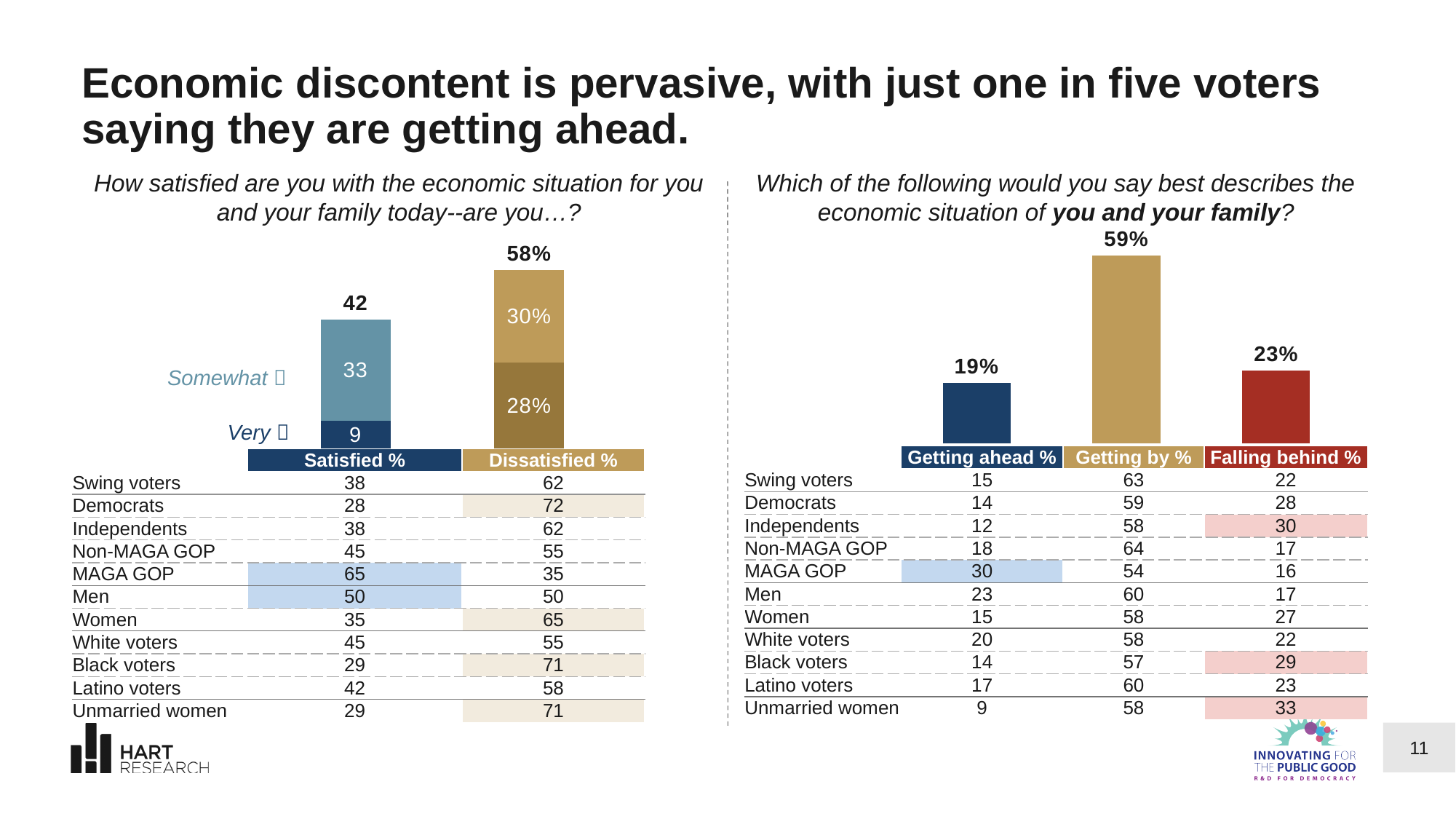
In the left chart (How satisfied are you with the economic situation), what kind of chart is shown? Stacked bar chart In the left chart (How satisfied are you with the economic situation), what is the 'Very' segment value of the Dissatisfied bar? 28% In the left chart (How satisfied are you with the economic situation), what is the 'Somewhat' segment value of the Satisfied bar? 33 In the left chart (How satisfied are you with the economic situation), what is the 'Very' segment value of the Satisfied bar? 9 In the left chart (How satisfied are you with the economic situation), what is the total for the Satisfied bar? 42 In the left chart (How satisfied are you with the economic situation), which bar is taller, Satisfied or Dissatisfied? Dissatisfied In the right chart (Which of the following best describes the economic situation of you and your family), how many bars are plotted? 3 In the right chart (Which of the following best describes the economic situation of you and your family), what is the difference between Getting by and Getting ahead? 40 percentage points In the right chart (Which of the following best describes the economic situation of you and your family), what is the value for Getting ahead? 19% In the left chart (How satisfied are you with the economic situation), what is the total for the Dissatisfied bar? 58% In the right chart (Which of the following best describes the economic situation of you and your family), which category has the highest value? Getting by In the right chart (Which of the following best describes the economic situation of you and your family), what is the value for Falling behind? 23%